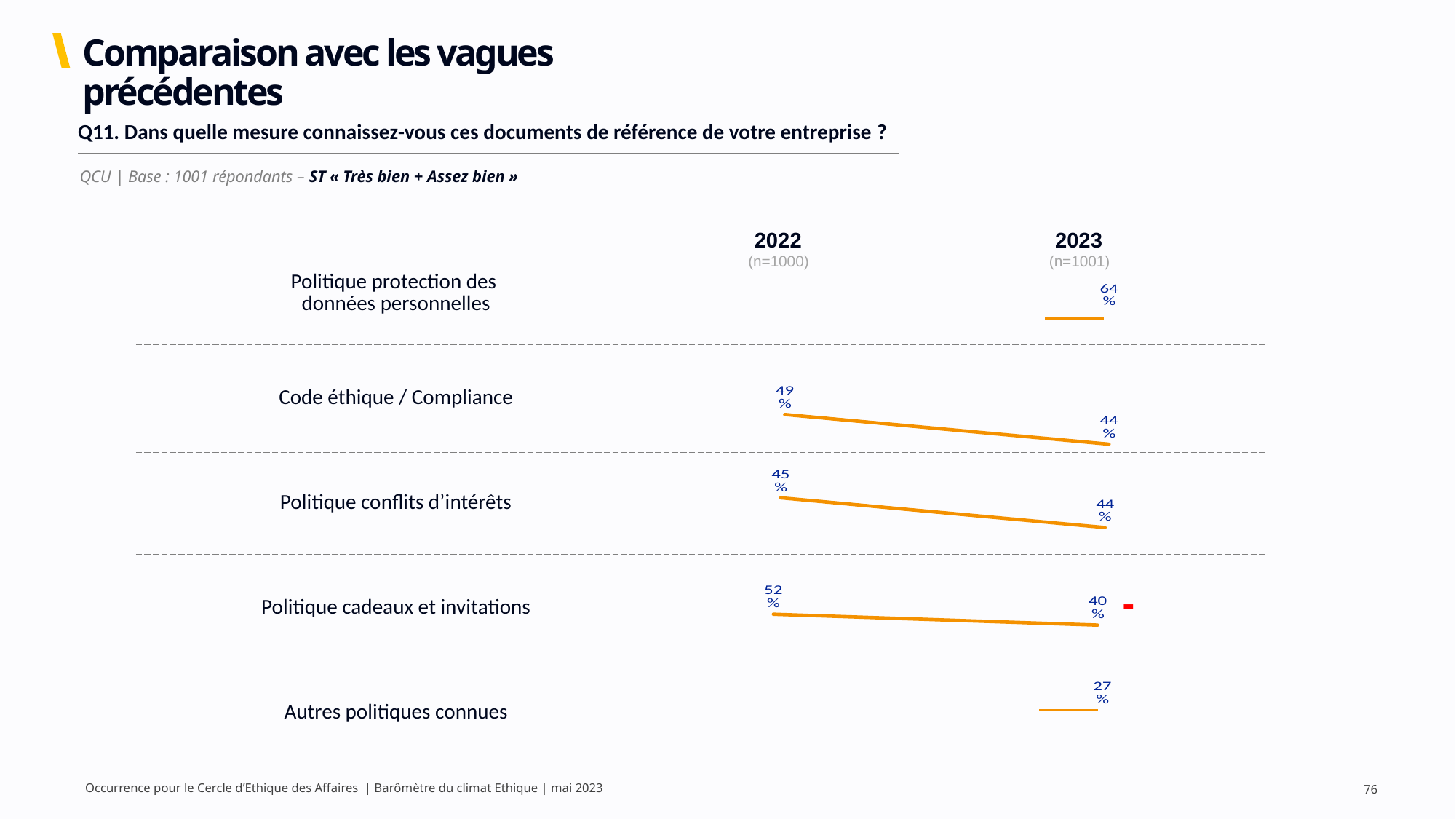
In the row for Politique cadeaux et invitations, does the value rise or fall from 2022 to 2023? fall Which row has the highest 2023 value? Politique protection des données personnelles In the row for Politique cadeaux et invitations, what is the difference between the 2022 and 2023 values? 12 points In the row for Code éthique / Compliance, what is the value for 2023? 44% In the row for Politique conflits d'intérêts, what is the value for 2022? 45% In the row for Politique protection des données personnelles, what is the value for 2023? 64% In the row for Code éthique / Compliance, what is the value for 2022? 49% Which row has the lowest 2023 value? Autres politiques connues In the row for Politique cadeaux et invitations, what is the value for 2023? 40% In the row for Code éthique / Compliance, what is the difference between the 2022 and 2023 values? 5 points In the row for Politique cadeaux et invitations, which year has the larger value, 2022 or 2023? 2022 In the row for Autres politiques connues, what is the value for 2023? 27%